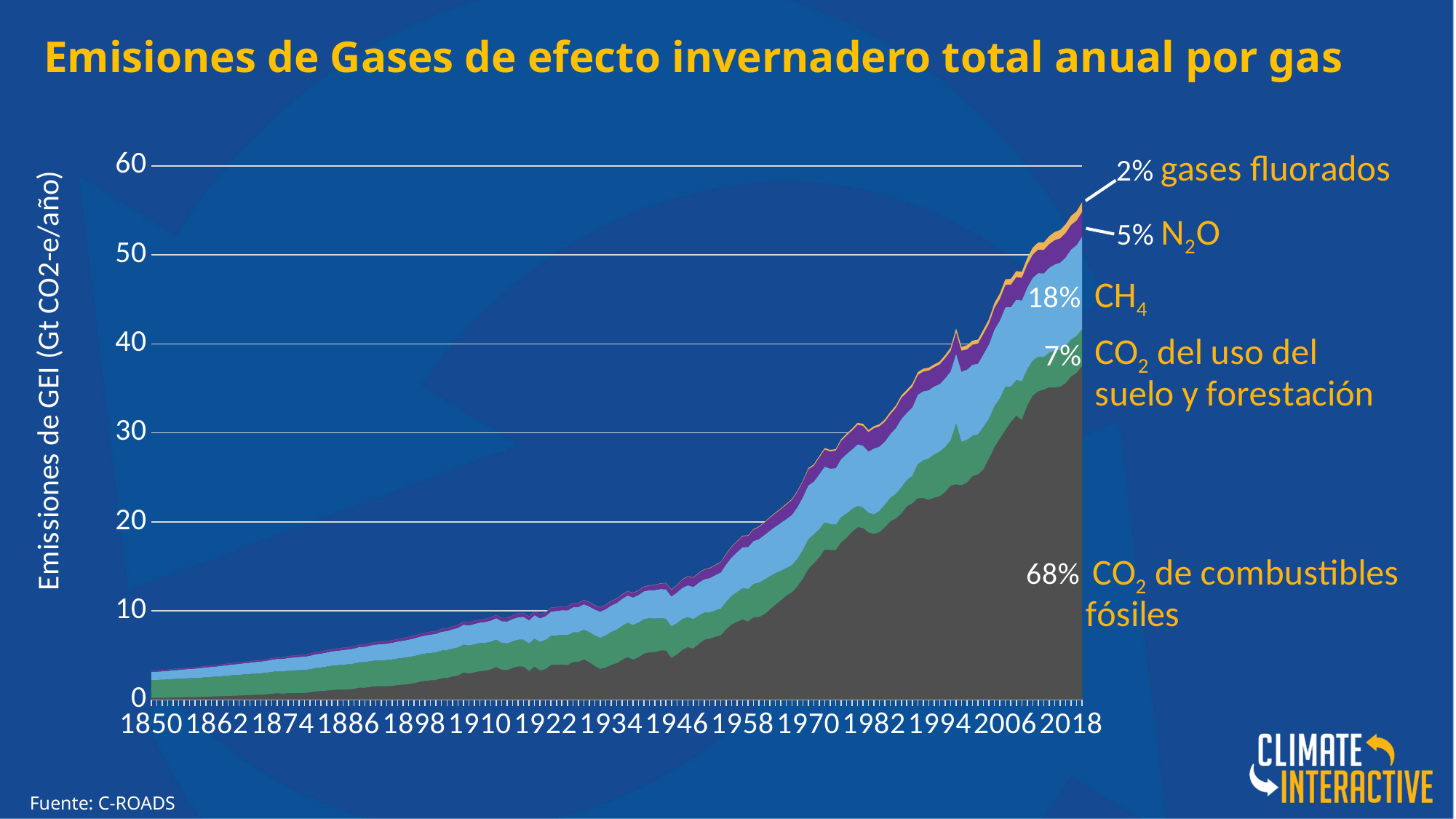
Which has a larger labelled share, N2O or CO2 del uso del suelo y forestación? CO2 del uso del suelo y forestación What is the title of the chart? Emisiones de Gases de efecto invernadero total anual por gas What percentage share is labelled for CH4? 18% How many gas categories are plotted in the chart? 5 What percentage share is labelled for N2O? 5% Is the total emissions value at the end of the series (2018) greater or less than 50 Gt CO2-e/año? greater Which gas category has the smallest labelled share of emissions? gases fluorados What is the difference in percentage points between the CH4 share and the CO2 del uso del suelo y forestación share? 11 Which gas category has the largest labelled share of emissions? CO2 de combustibles fósiles What type of chart is shown on the slide? Stacked area chart What percentage share is labelled for gases fluorados? 2% What percentage share is labelled for CO2 de combustibles fósiles? 68%